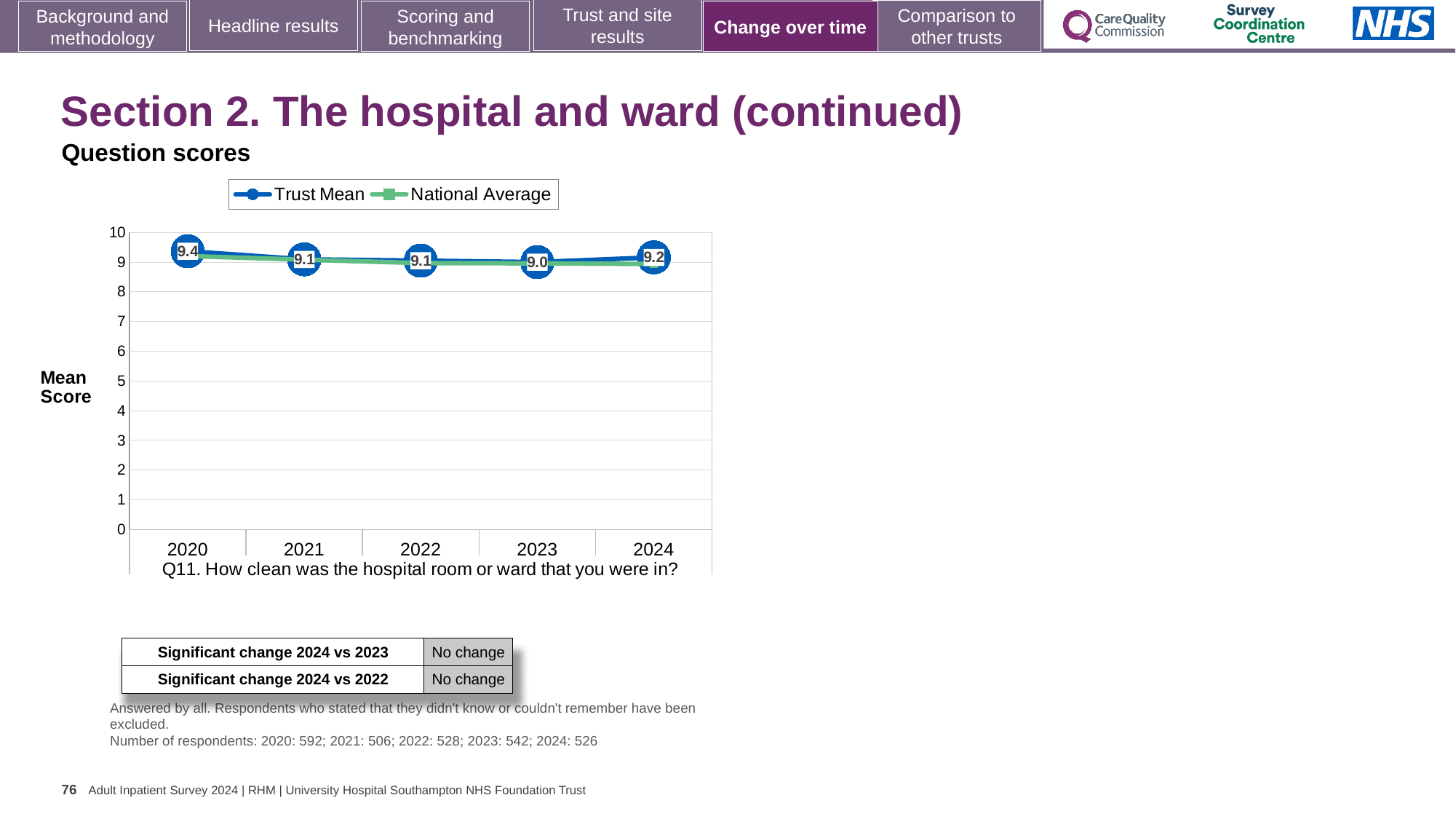
Is the Trust Mean score for 2024 higher or lower than the Trust Mean score for 2023? higher What is the Trust Mean score for 2020 in the Q11 chart? 9.4 What is the difference between the Trust Mean scores for 2020 and 2023? 0.4 Which year has the highest Trust Mean score in the Q11 chart? 2020 What is the label on the y axis of the chart? Mean Score What kind of chart is shown on the slide? line chart Which year has the lowest Trust Mean score in the Q11 chart? 2023 What is the Trust Mean score for 2023 in the Q11 chart? 9.0 Is the Trust Mean value for 2021 greater or less than 8? greater How many series does the chart legend list? 2 What is the Trust Mean score for 2024 in the Q11 chart? 9.2 How many years are shown on the x axis of the chart? 5